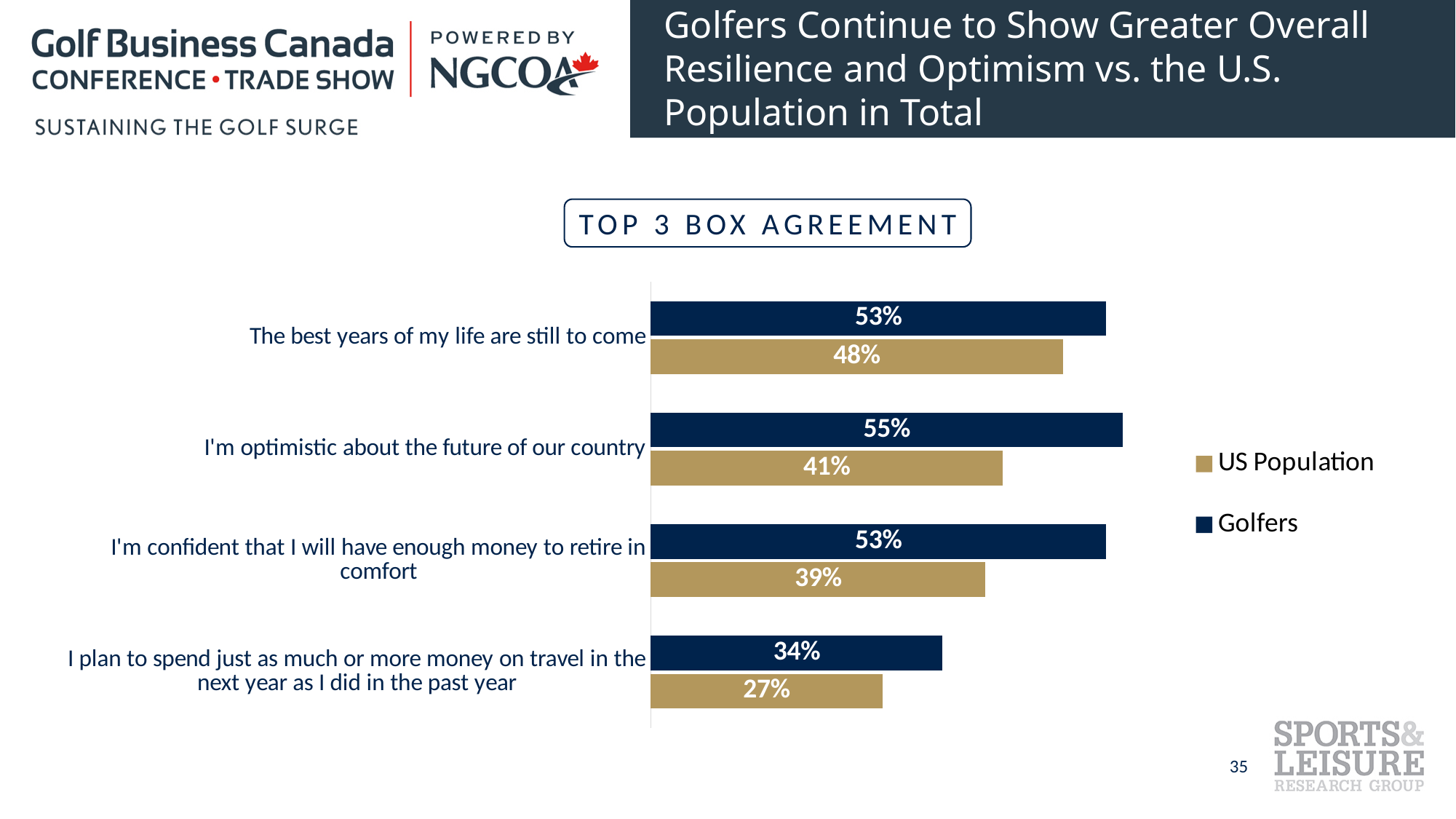
Which statement has the highest Golfers agreement? I'm optimistic about the future of our country How many statements are shown in the chart? 4 What percentage of Golfers agree that the best years of their life are still to come? 53% For "The best years of my life are still to come", which group has the higher agreement, Golfers or US Population? Golfers What is the difference between Golfers and US Population for "I'm optimistic about the future of our country"? 14 percentage points What is the Golfers value for "I'm confident that I will have enough money to retire in comfort"? 53% What percentage of the US Population agrees with "I'm optimistic about the future of our country"? 41% How many series does the legend list? 2 What is the US Population value for "I plan to spend just as much or more money on travel in the next year as I did in the past year"? 27% What is the difference between Golfers and US Population for "I'm confident that I will have enough money to retire in comfort"? 14 percentage points Which statement has the lowest US Population agreement? I plan to spend just as much or more money on travel in the next year as I did in the past year What type of chart is shown on the slide? Bar chart